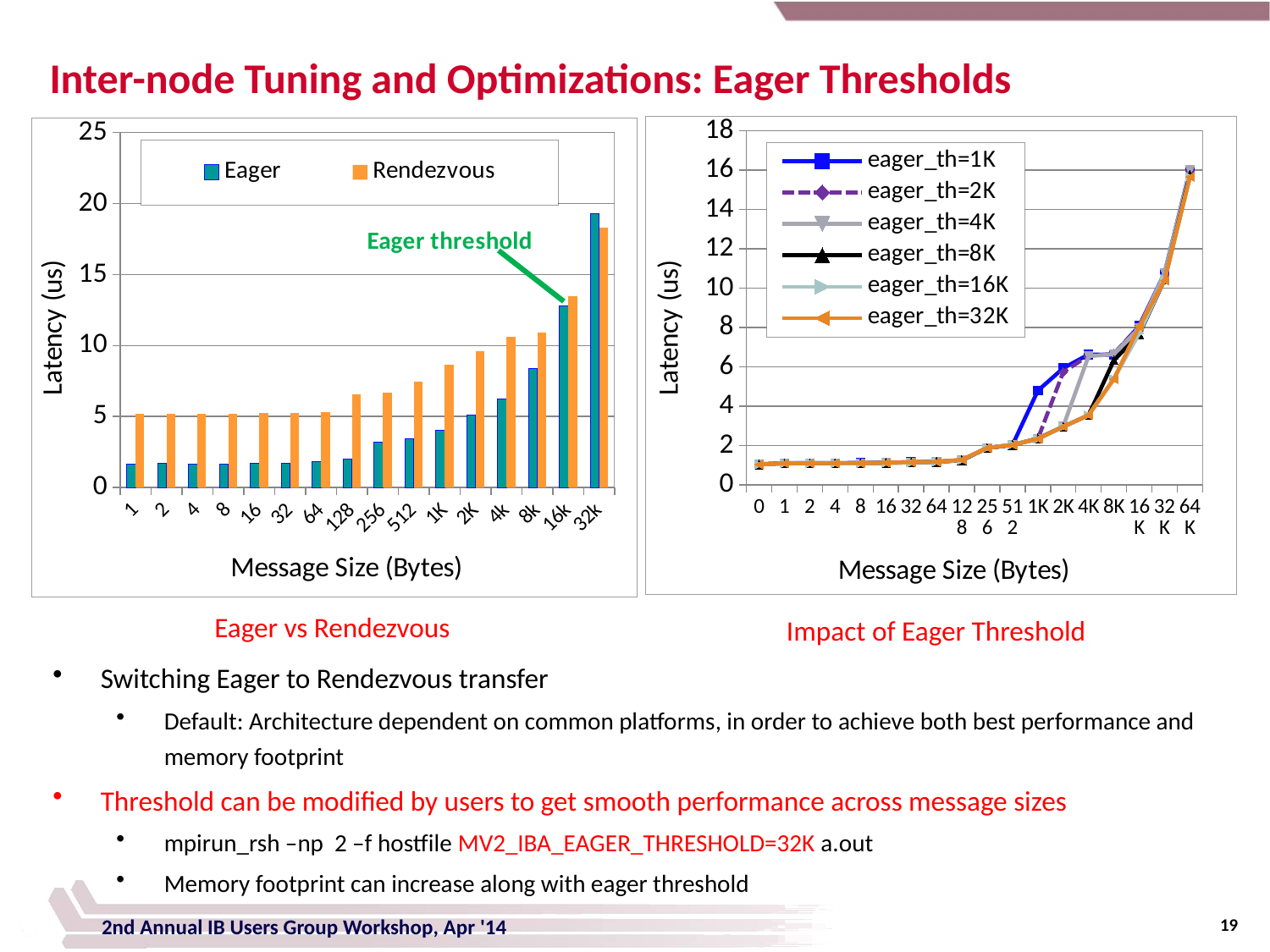
In the left chart (Eager vs Rendezvous), is the Eager latency at 32k greater or less than 15? greater In the left chart (Eager vs Rendezvous), how many series does the legend list? 2 In the left chart (Eager vs Rendezvous), at which message size is the Eager latency highest? 32k In the left chart (Eager vs Rendezvous), at message size 128, which series has the higher latency, Eager or Rendezvous? Rendezvous In the right chart (Impact of Eager Threshold), how many series does the legend list? 6 In the right chart (Impact of Eager Threshold), how many message size points are shown on the x axis? 18 In the left chart (Eager vs Rendezvous), is the Eager latency at message size 1 greater or less than 5? less In the right chart (Impact of Eager Threshold), do the latency values generally rise or fall as message size increases along the x axis? rise In the left chart (Eager vs Rendezvous), how many message size categories are shown on the x axis? 16 In the right chart (Impact of Eager Threshold), is the latency for eager_th=32K at 64K greater or less than 14? greater What kind of chart is the left chart (Eager vs Rendezvous)? bar chart What kind of chart is the right chart (Impact of Eager Threshold)? line chart